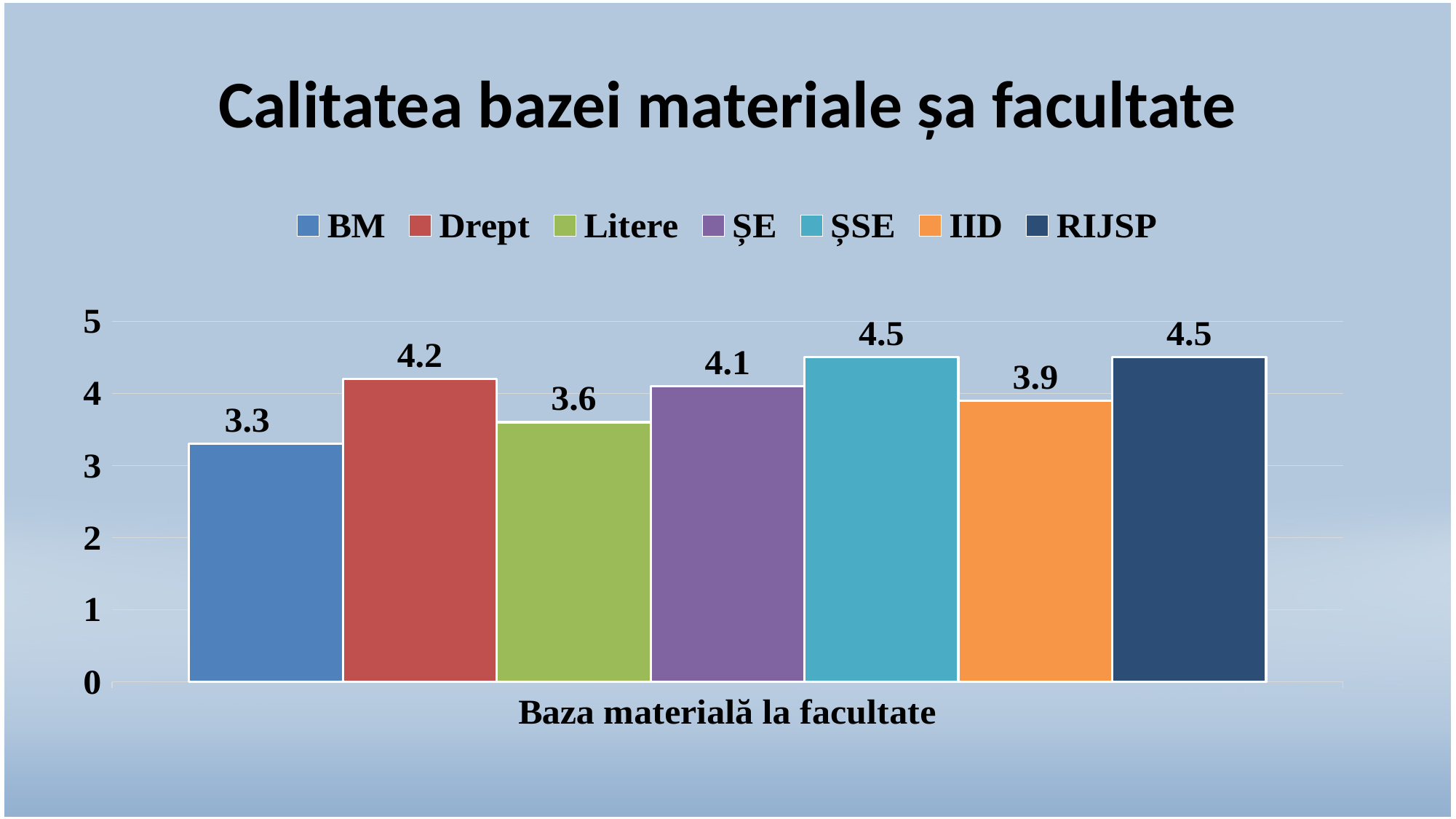
Is the value for BM greater or less than 4? less What is the value for Drept? 4.2 What is the difference between the values for ȘSE and BM? 1.2 Which is larger, the value for Litere or the value for IID? IID What is the value for IID? 3.9 How many series does the legend list? 7 Which series has the lowest value? BM What is the label shown below the x axis? Baza materială la facultate What is the difference between the values for Drept and ȘE? 0.1 What is the title of the chart? Calitatea bazei materiale șa facultate What is the value for Litere? 3.6 What kind of chart is shown on the slide? bar chart